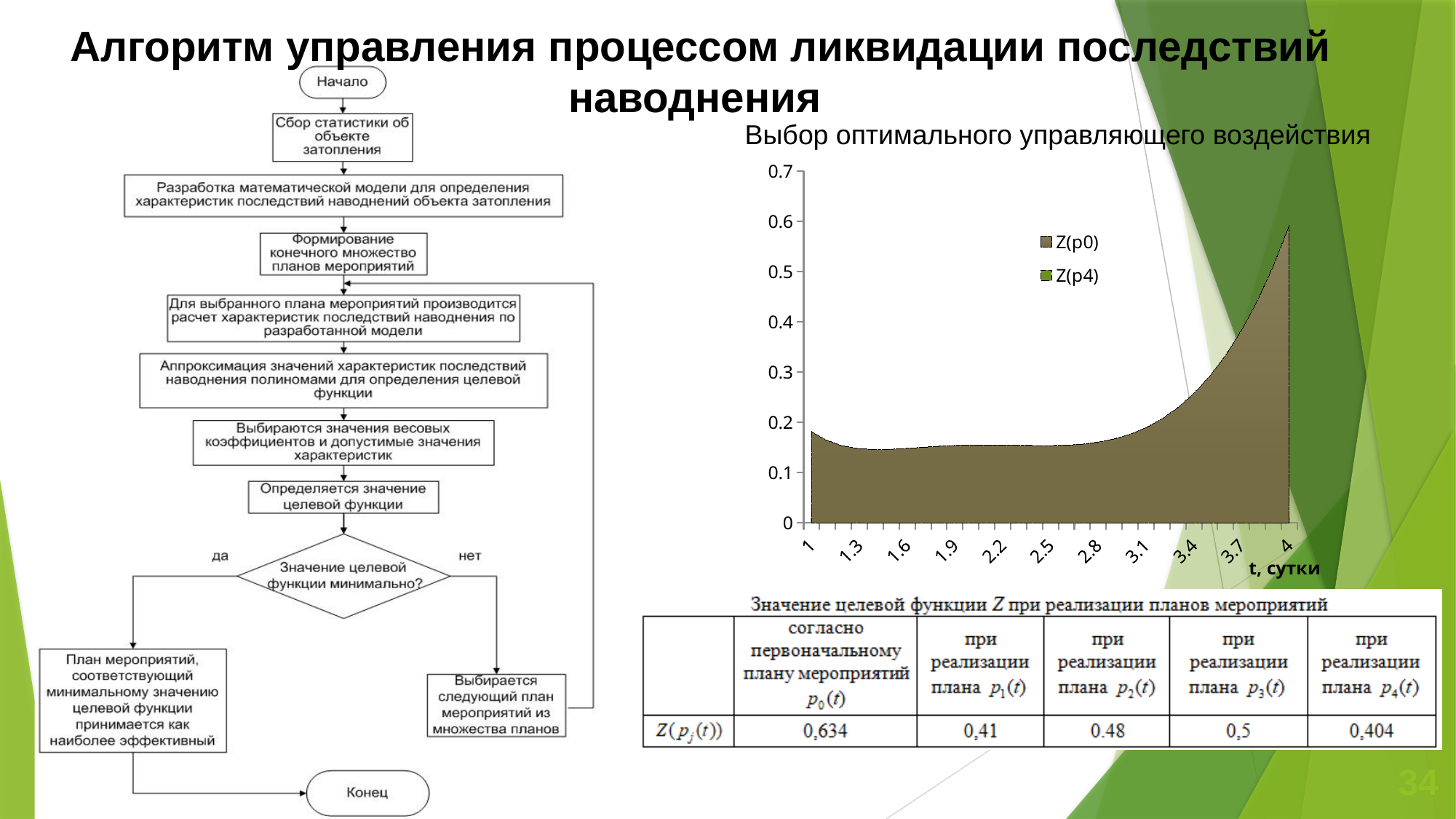
At which value of t on the x axis does the plotted area reach its highest value? 4 How many tick labels are shown on the x axis of the chart? 11 Is the value of the plotted area at t = 3.7 greater or less than 0.3? greater Between t = 3.1 and t = 4, does the plotted value rise or fall? rise Is the value of the plotted area at t = 2.5 greater or less than 0.2? less What kind of chart is shown under the heading "Выбор оптимального управляющего воздействия"? area chart Is the value of the plotted area at t = 1 greater or less than 0.2? less What are the two entries in the chart's legend? Z(p0) and Z(p4) How many series does the legend of the chart list? 2 What is the label of the x axis of the chart? t, сутки What is the highest tick value shown on the y axis of the chart? 0.7